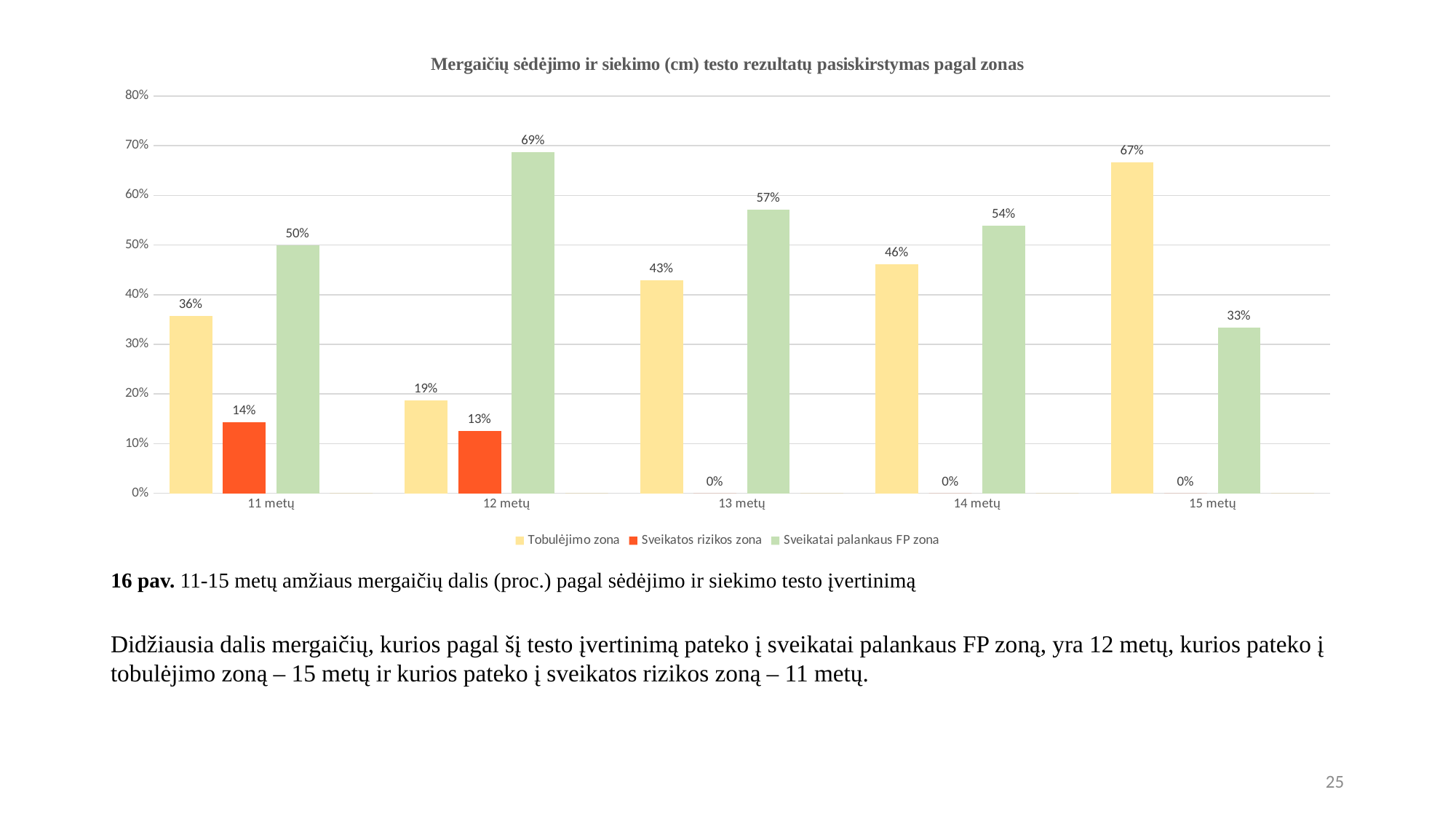
What is the title of the chart? Mergaičių sėdėjimo ir siekimo (cm) testo rezultatų pasiskirstymas pagal zonas Which is larger at 13 metų: Tobulėjimo zona or Sveikatai palankaus FP zona? Sveikatai palankaus FP zona How many series does the legend list? 3 Which age group has the lowest value for Sveikatai palankaus FP zona? 15 metų What is the value for Sveikatai palankaus FP zona at 12 metų? 69% What is the value for Sveikatos rizikos zona at 13 metų? 0% How many age groups are shown on the x axis? 5 What is the value for Tobulėjimo zona at 11 metų? 36% What is the difference between Sveikatai palankaus FP zona and Tobulėjimo zona at 14 metų? 8% Which age group has the highest value for Tobulėjimo zona? 15 metų What kind of chart is shown on the slide? Bar chart Is the value for Sveikatai palankaus FP zona at 11 metų greater or less than 40%? greater